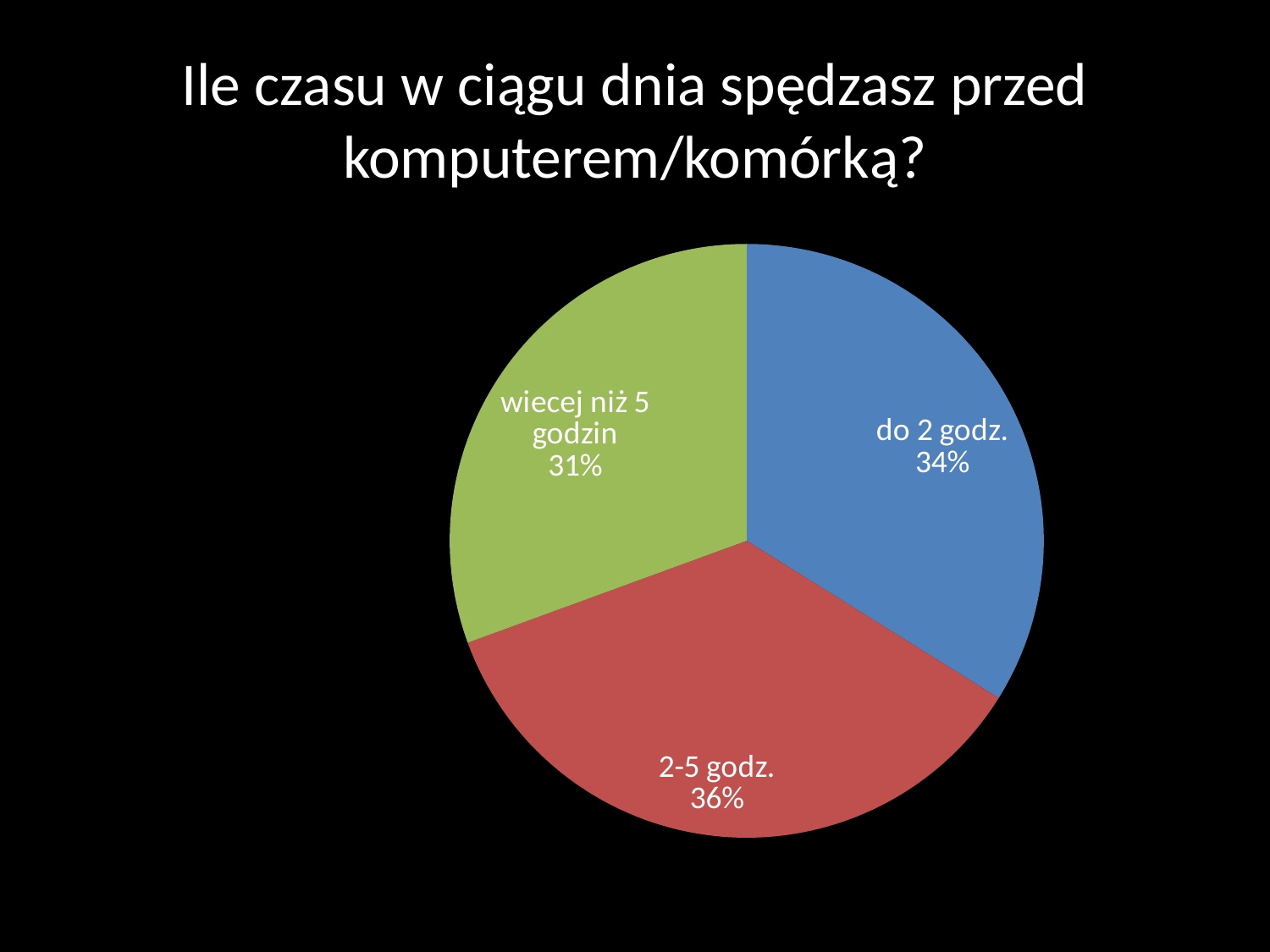
What colour is the "2-5 godz." slice? red What share of the pie is labelled "do 2 godz."? 34% What share of the pie is labelled "2-5 godz."? 36% How many slices does the pie chart have? 3 What share of the pie is labelled "wiecej niż 5 godzin"? 31% What is the title of the chart? Ile czasu w ciągu dnia spędzasz przed komputerem/komórką? What is the difference in percentage points between the "do 2 godz." slice and the "wiecej niż 5 godzin" slice? 3 What kind of chart is shown on the slide? pie chart Which category has the smallest share of the pie? wiecej niż 5 godzin What is the difference in percentage points between the "2-5 godz." slice and the "wiecej niż 5 godzin" slice? 5 Which category has the largest share of the pie? 2-5 godz. Which is larger, the share for "do 2 godz." or the share for "2-5 godz."? 2-5 godz.